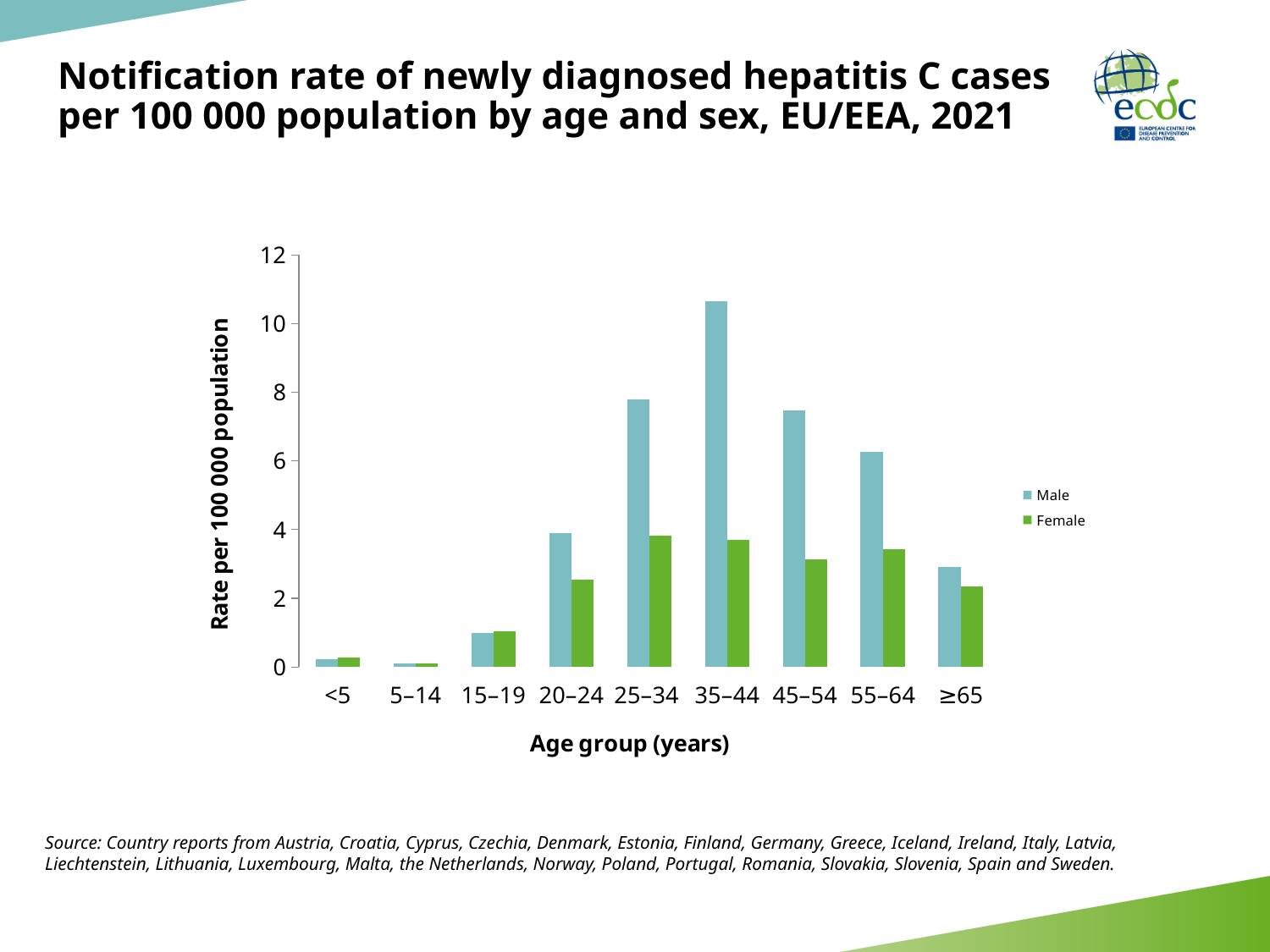
Do the male rates rise or fall from the 35–44 age group to the ≥65 age group? fall In the 35–44 age group, is the rate higher for males or females? Male What kind of chart is shown on the slide? bar chart Which age group has the lowest notification rate for males? 5–14 Is the female rate for the 20–24 age group greater or less than 2? greater Which age group has the highest notification rate for males? 35–44 Is the male rate for the 35–44 age group greater or less than 10? greater Is the male rate for the 45–54 age group greater or less than 6? greater How many age groups are shown on the x axis? 9 How many series does the legend list? 2 What is the title of the y axis? Rate per 100 000 population